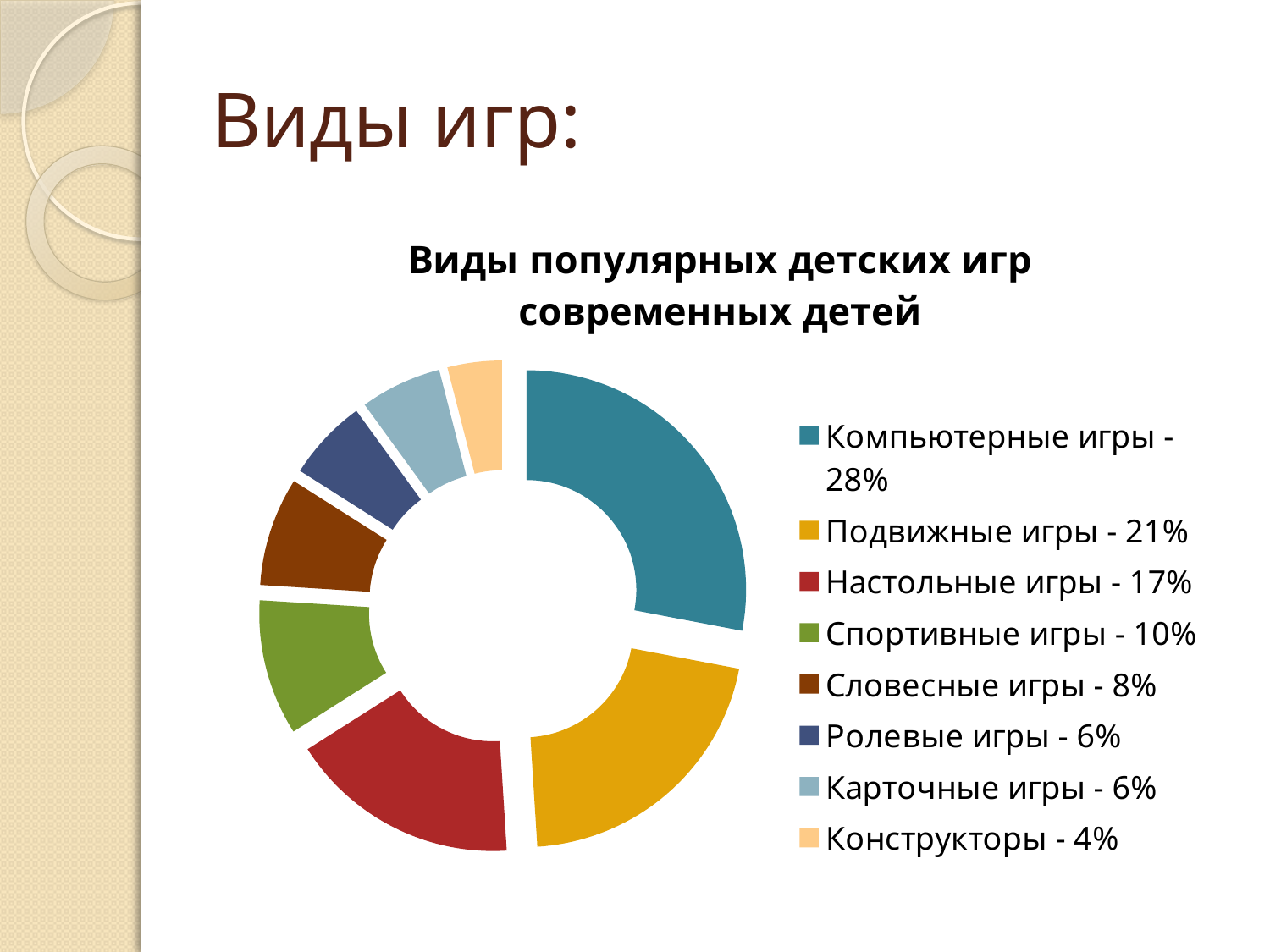
What percentage is shown for Компьютерные игры? 28% What percentage is shown for Настольные игры? 17% What kind of chart is shown on the slide? Doughnut (pie) chart What colour is the slice for Подвижные игры? Yellow (gold) How many categories does the chart show? 8 Which is larger: the share of Спортивные игры or Словесные игры? Спортивные игры Which category has the smallest share? Конструкторы What percentage is shown for Конструкторы? 4% What is the combined share of Ролевые игры and Карточные игры? 12% Which category has the largest share? Компьютерные игры What is the difference between the shares of Компьютерные игры and Подвижные игры? 7% What is the title of the chart? Виды популярных детских игр современных детей